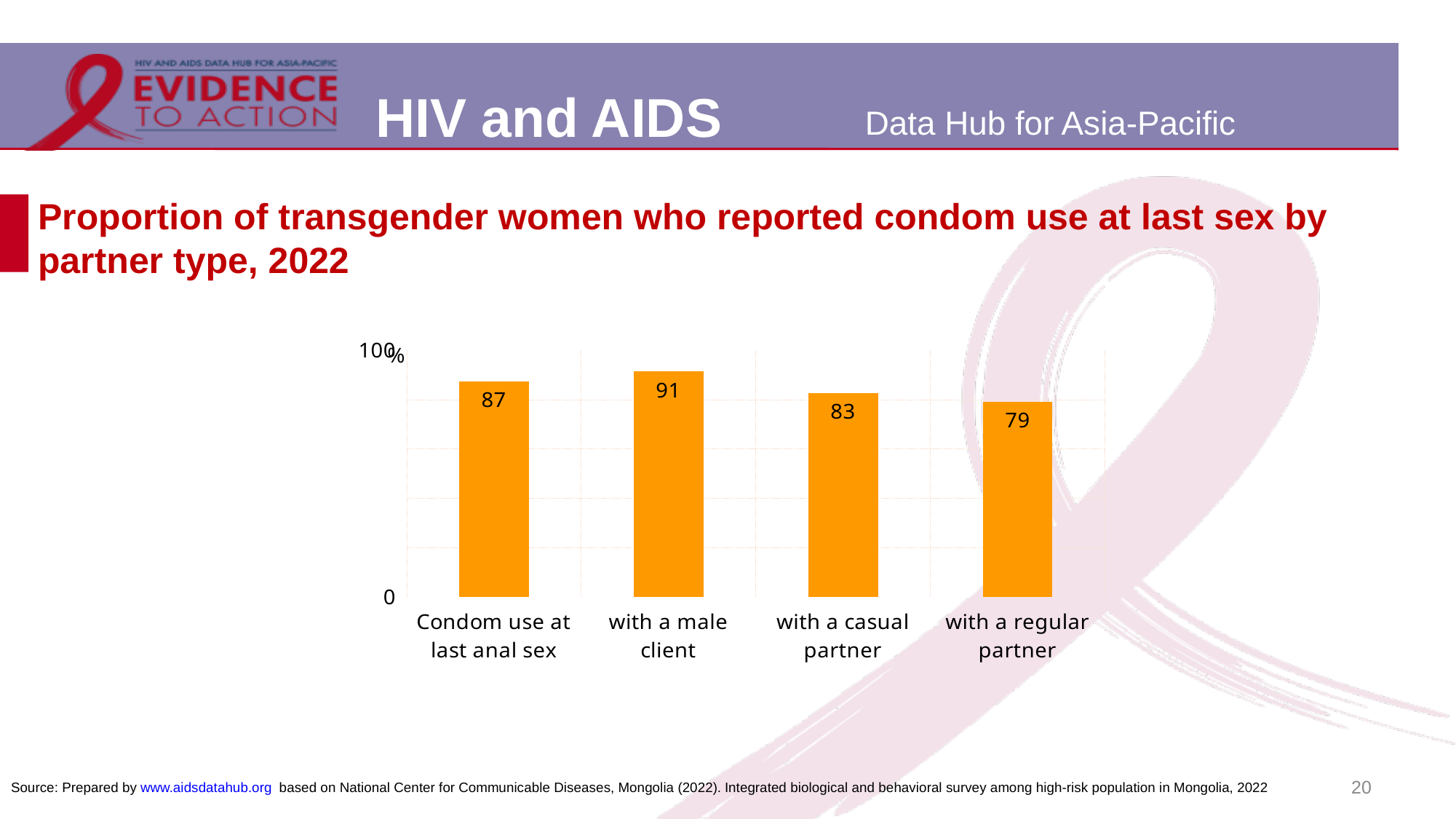
What is the value for 'Condom use at last anal sex'? 87 What is the difference between the values for 'with a male client' and 'with a regular partner'? 12 Which category has the highest value? with a male client What is the maximum value shown on the vertical axis? 100 Which is larger, the value for 'with a casual partner' or the value for 'with a regular partner'? with a casual partner Which category has the lowest value? with a regular partner How many categories are shown in the chart? 4 What is the value for 'with a regular partner'? 79 What is the value for 'with a casual partner'? 83 What kind of chart is shown on the slide? bar chart What is the value for 'with a male client'? 91 What is the difference between the values for 'Condom use at last anal sex' and 'with a casual partner'? 4